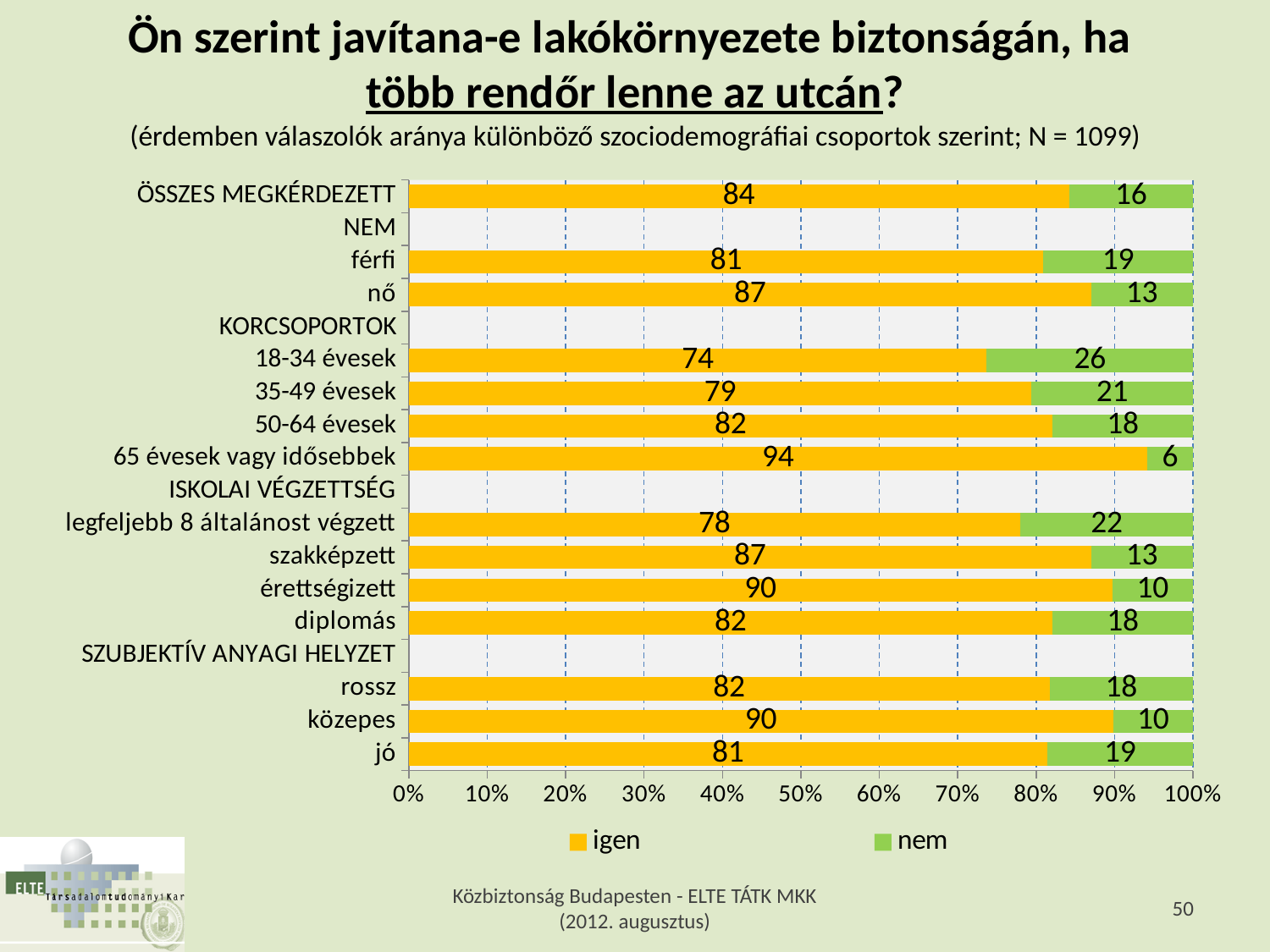
What is the 'igen' value for érettségizett? 90 Which category has the highest 'igen' value? 65 évesek vagy idősebbek What is the 'igen' value for ÖSSZES MEGKÉRDEZETT? 84 What kind of chart is shown on the slide? stacked bar chart How many series does the legend list? 2 What is the total of the stacked bar for diplomás? 100 Is the 'igen' value for 35-49 évesek greater or less than 80%? less Which has a larger 'nem' value, rossz or közepes? rossz What colour represents the 'nem' series? green Which category has the lowest 'igen' value? 18-34 évesek What is the 'nem' value for 18-34 évesek? 26 What is the difference between the 'igen' values for nő and férfi? 6